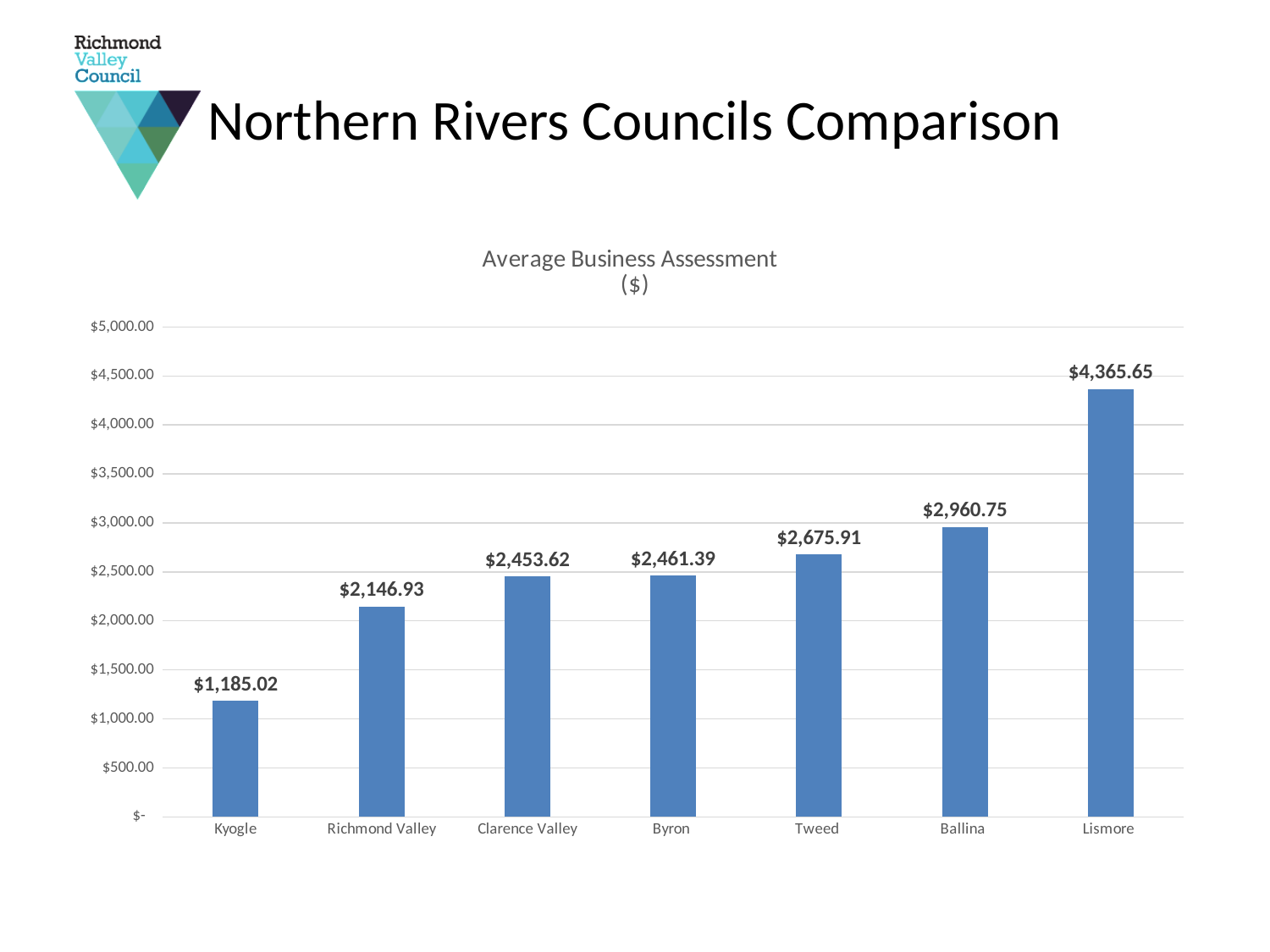
Do the values generally rise or fall from left to right across the councils? Rise What is the average business assessment for Richmond Valley? $2,146.93 What is the average business assessment for Tweed? $2,675.91 What is the difference between the average business assessment for Ballina and Tweed? $284.84 How many councils are shown in the chart? 7 Which council has the lowest average business assessment? Kyogle Which council has the highest average business assessment? Lismore Which has a higher average business assessment, Ballina or Richmond Valley? Ballina What type of chart is shown on the slide? Bar chart What is the average business assessment for Kyogle? $1,185.02 What is the difference between the average business assessment for Lismore and Kyogle? $3,180.63 Is the average business assessment for Lismore greater or less than $4,000.00? greater